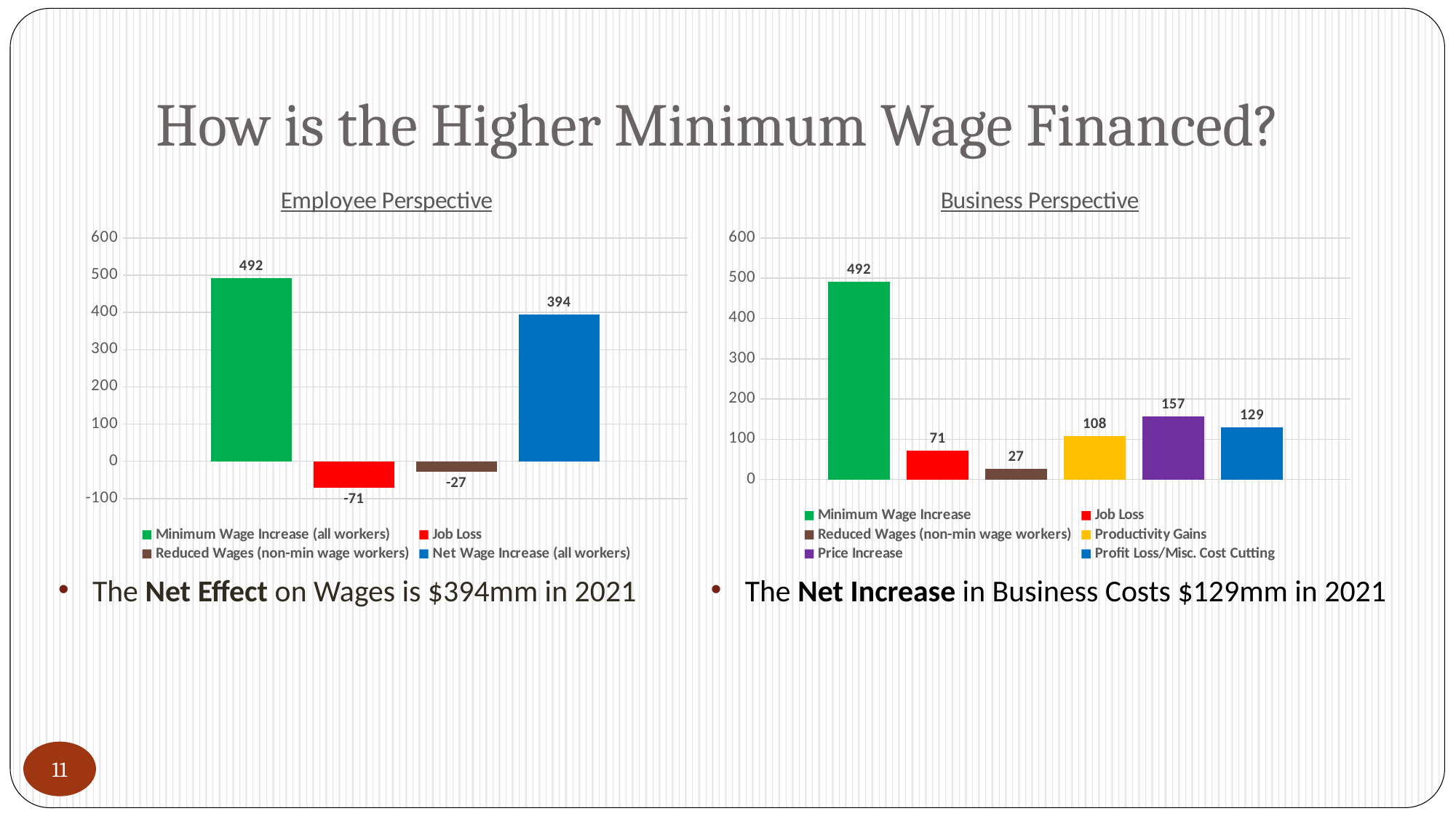
What kind of chart is the Employee Perspective chart? Bar chart In the Business Perspective chart, what is the value for Productivity Gains? 108 In the Employee Perspective chart, what is the difference between Minimum Wage Increase (all workers) and Net Wage Increase (all workers)? 98 In the Business Perspective chart, which is larger: Price Increase or Profit Loss/Misc. Cost Cutting? Price Increase In the Business Perspective chart, what is the value for Price Increase? 157 How many series does the legend of the Business Perspective chart list? 6 In the Business Perspective chart, which series has the lowest value? Reduced Wages (non-min wage workers) In the Employee Perspective chart, what is the value for Job Loss? -71 In the Employee Perspective chart, which series has the lowest value? Job Loss In the Employee Perspective chart, which series has the highest value? Minimum Wage Increase (all workers) In the Employee Perspective chart, what is the value for Net Wage Increase (all workers)? 394 In the Business Perspective chart, what is the difference between Price Increase and Job Loss? 86